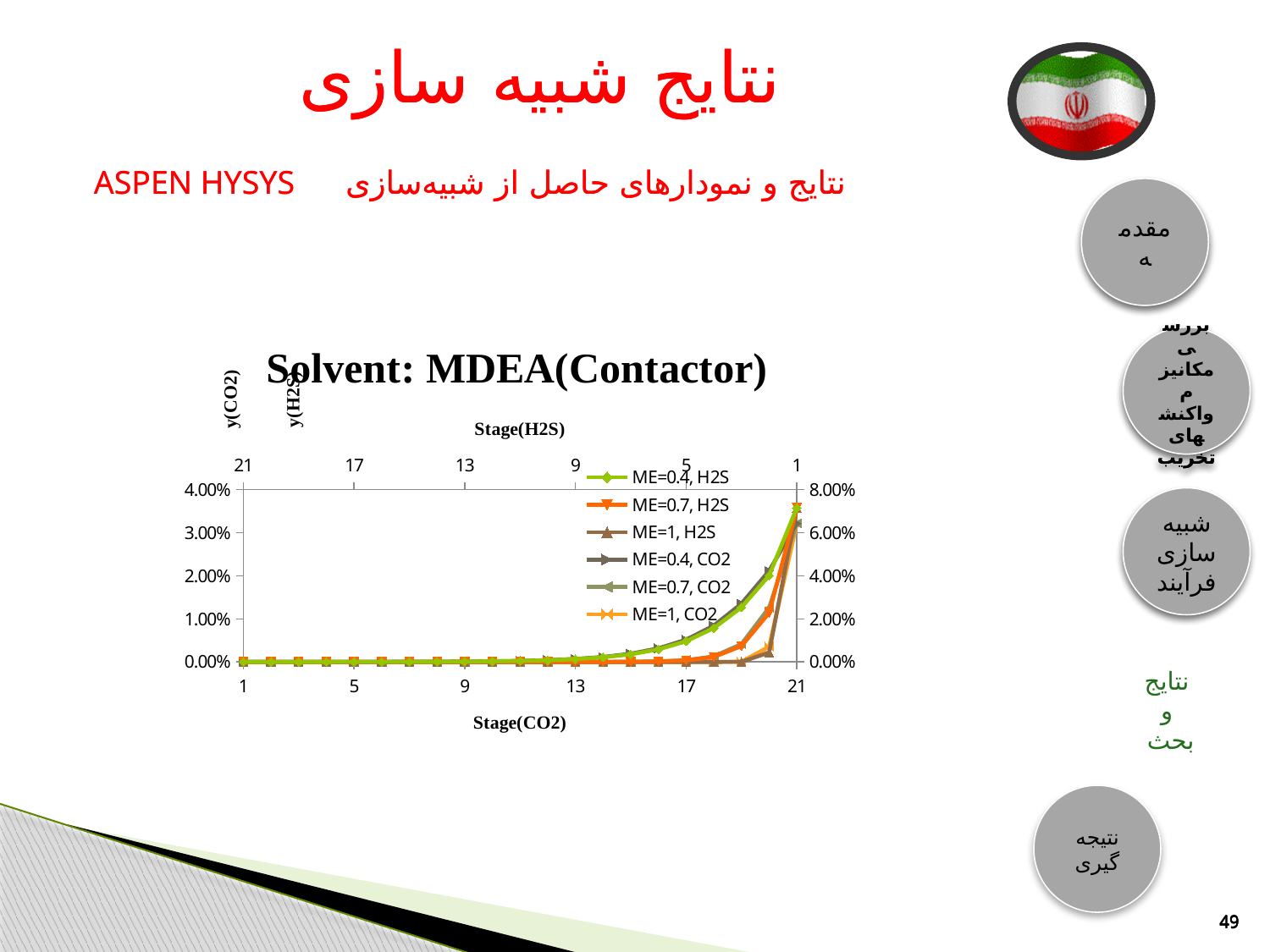
What is the title of the chart? Solvent: MDEA(Contactor) Do the plotted values rise or fall as the stage number on the bottom axis increases from 1 to 21? rise What is the maximum value shown on the left y axis of the chart? 4.00% How many series does the chart's legend list? 6 What kind of chart is shown on the slide? line chart What is the maximum value shown on the right y axis of the chart? 8.00%